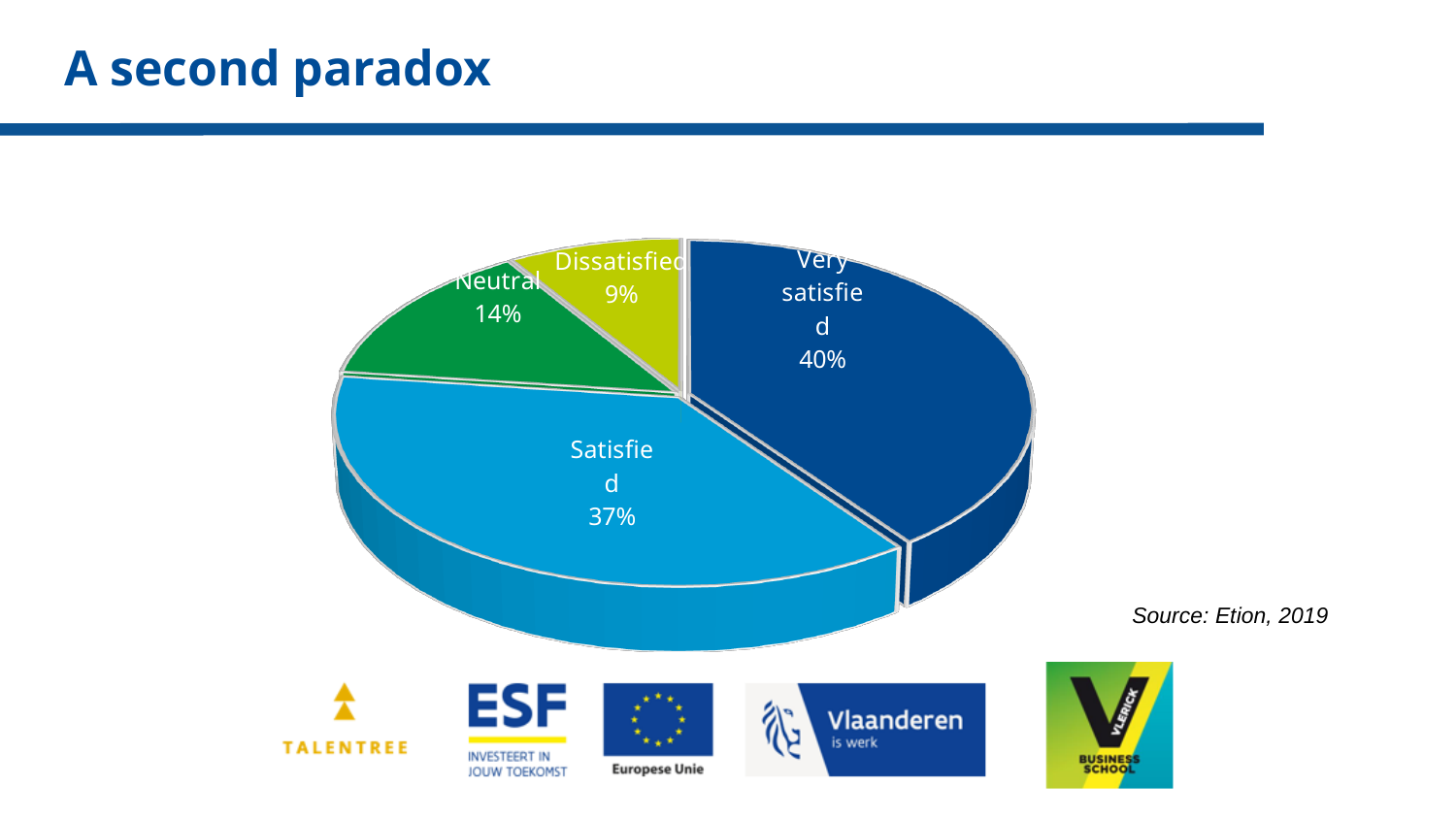
What percentage of the pie is labelled "Neutral"? 14% What percentage of the pie is labelled "Very satisfied"? 40% Which slice of the pie is the largest? Very satisfied What is the combined share of the "Very satisfied" and "Satisfied" slices? 77% What percentage of the pie is labelled "Dissatisfied"? 9% What kind of chart is shown on the slide? pie chart Which slice of the pie is the smallest? Dissatisfied What is the difference in percentage points between the "Very satisfied" and "Satisfied" slices? 3 Which is larger, the "Neutral" slice or the "Dissatisfied" slice? Neutral How many slices does the pie chart have? 4 What percentage of the pie is labelled "Satisfied"? 37% What is the title of the slide containing the pie chart? A second paradox